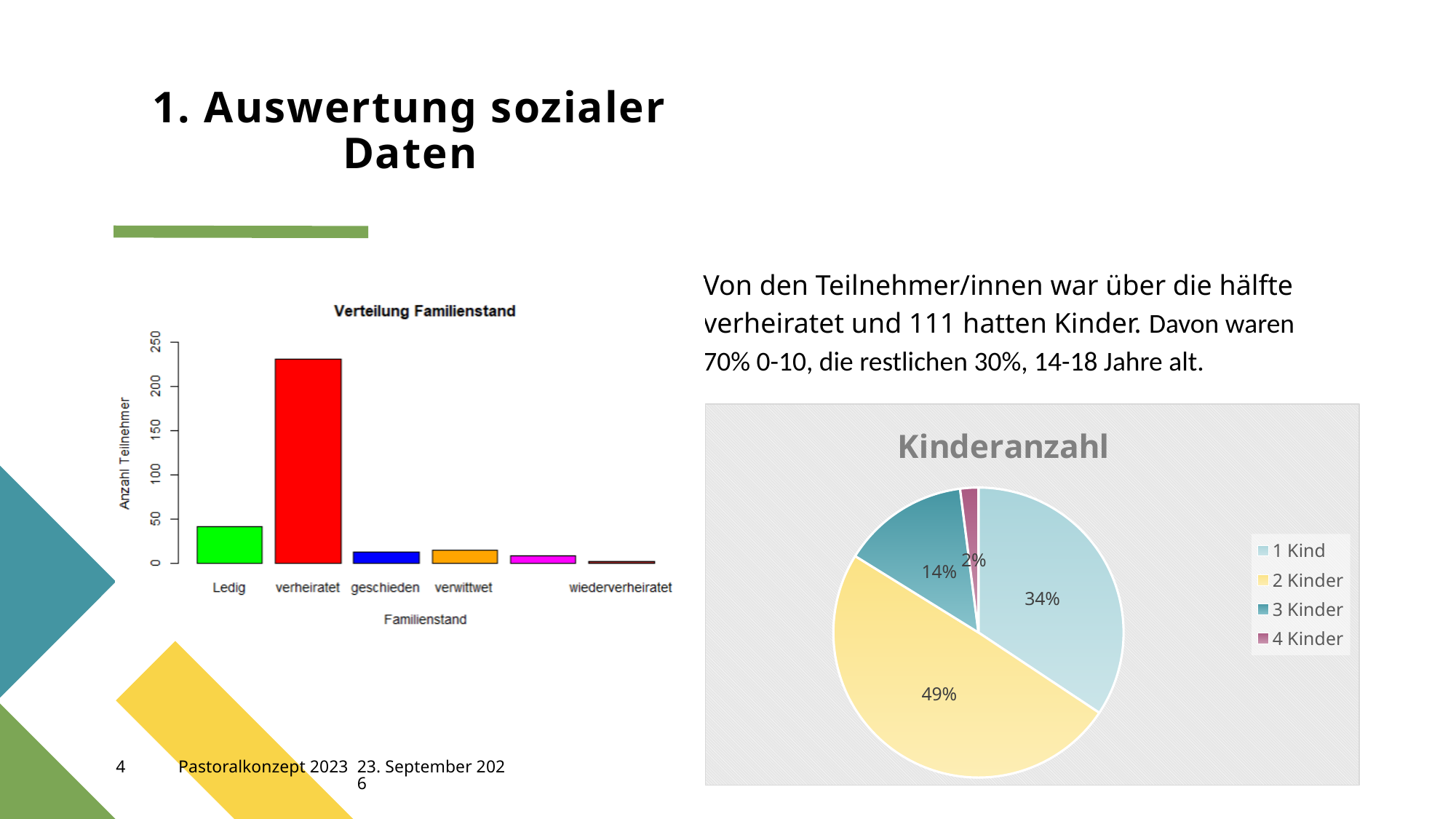
In the pie chart titled Kinderanzahl, what share is shown for 1 Kind? 34% In the chart titled Verteilung Familienstand, which category has the highest bar? verheiratet In the pie chart titled Kinderanzahl, what share is shown for 2 Kinder? 49% In the chart titled Verteilung Familienstand, is the value for verheiratet greater or less than 200? greater In the pie chart titled Kinderanzahl, which category has the smallest share? 4 Kinder In the pie chart titled Kinderanzahl, which category has the largest share? 2 Kinder In the pie chart titled Kinderanzahl, what share is shown for 4 Kinder? 2% In the pie chart titled Kinderanzahl, how many entries does the legend list? 4 In the chart titled Verteilung Familienstand, is the value for Ledig greater or less than 100? less What kind of chart is the chart titled Verteilung Familienstand? bar chart In the chart titled Verteilung Familienstand, which is larger, the value for Ledig or the value for geschieden? Ledig In the pie chart titled Kinderanzahl, what is the difference in percentage points between 2 Kinder and 3 Kinder? 35